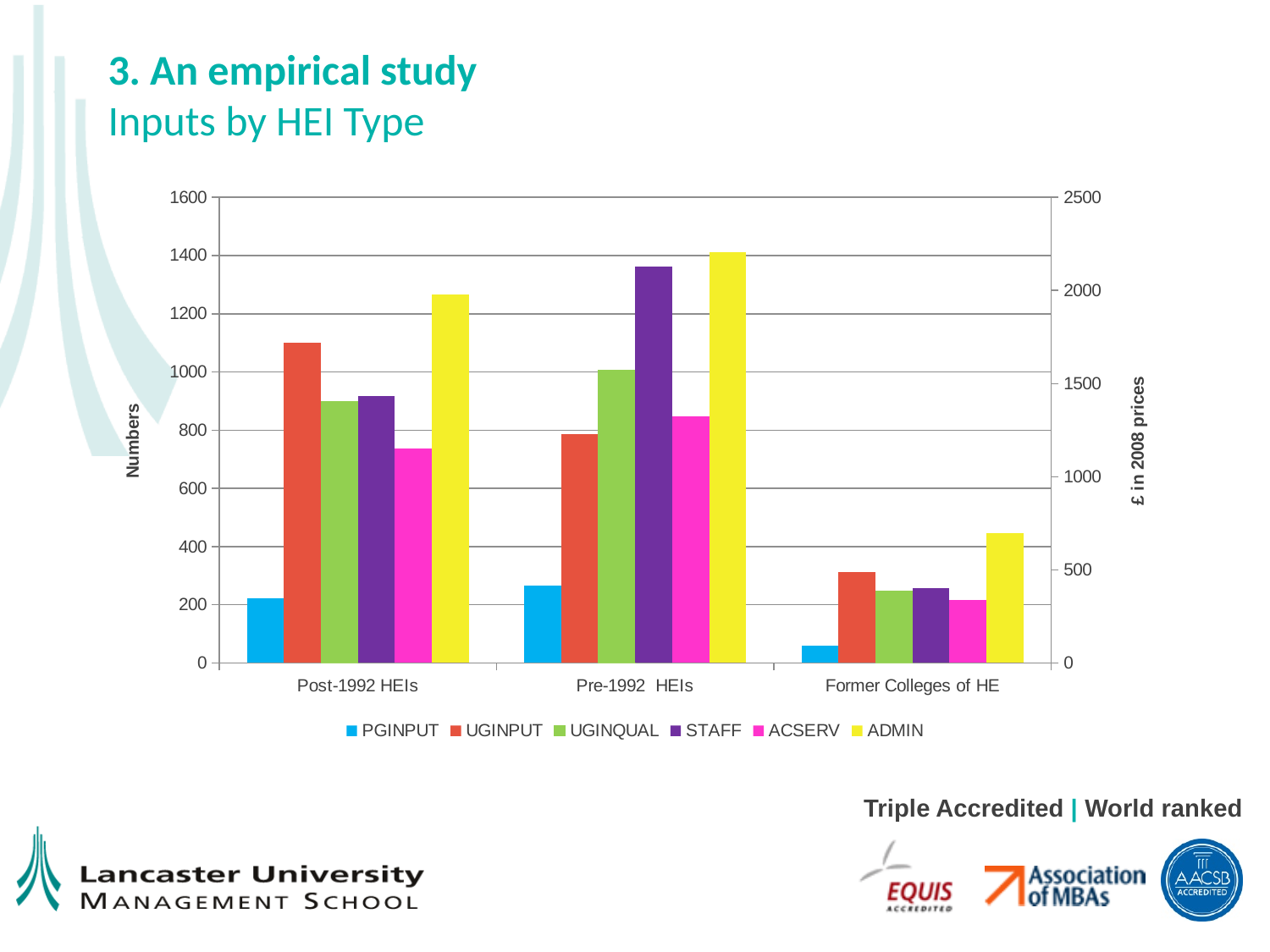
Which series has the shortest bar for Former Colleges of HE? PGINPUT How many HEI type categories are shown on the x axis? 3 For Post-1992 HEIs, which is larger: UGINPUT or UGINQUAL? UGINPUT Which series has the tallest bar for Pre-1992 HEIs? ADMIN Which series has the shortest bar for Post-1992 HEIs? PGINPUT What is the title of the right vertical axis? £ in 2008 prices What kind of chart is shown on the slide? Bar chart How many series does the legend list? 6 For Pre-1992 HEIs, which is larger: STAFF or ACSERV? STAFF What is the title of the left vertical axis? Numbers Is the ADMIN value for Pre-1992 HEIs greater or less than 1000? greater Is the PGINPUT value for Former Colleges of HE greater or less than 200? less